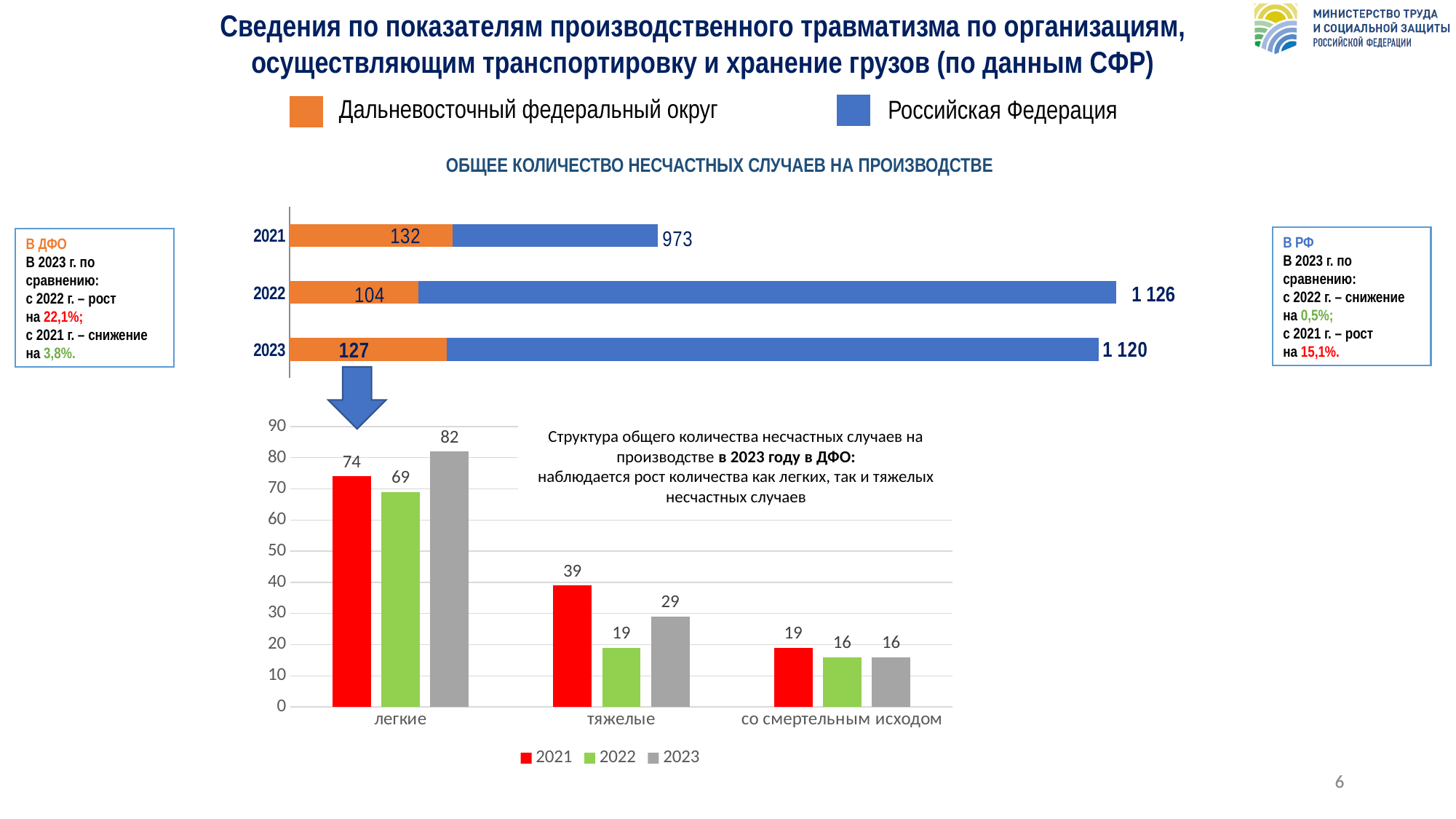
In the bottom chart, what is the value for легкие in 2023? 82 In the top chart 'ОБЩЕЕ КОЛИЧЕСТВО НЕСЧАСТНЫХ СЛУЧАЕВ НА ПРОИЗВОДСТВЕ', what is the difference between the Российская Федерация values for 2022 and 2021? 153 In the top chart 'ОБЩЕЕ КОЛИЧЕСТВО НЕСЧАСТНЫХ СЛУЧАЕВ НА ПРОИЗВОДСТВЕ', what is the value for Дальневосточный федеральный округ in 2021? 132 In the bottom chart, how many series does the legend list? 3 In the top chart 'ОБЩЕЕ КОЛИЧЕСТВО НЕСЧАСТНЫХ СЛУЧАЕВ НА ПРОИЗВОДСТВЕ', what is the value for Российская Федерация in 2022? 1 126 What kind of chart is the bottom chart? Bar chart In the bottom chart, what is the value for тяжелые in 2022? 19 In the top chart 'ОБЩЕЕ КОЛИЧЕСТВО НЕСЧАСТНЫХ СЛУЧАЕВ НА ПРОИЗВОДСТВЕ', in which year is the value for Дальневосточный федеральный округ lowest? 2022 In the bottom chart, which category has the highest value in 2021? легкие In the bottom chart, which is larger: the 2021 value for тяжелые or the 2023 value for тяжелые? 2021 value for тяжелые In the top chart 'ОБЩЕЕ КОЛИЧЕСТВО НЕСЧАСТНЫХ СЛУЧАЕВ НА ПРОИЗВОДСТВЕ', what is the value for Дальневосточный федеральный округ in 2023? 127 In the top chart 'ОБЩЕЕ КОЛИЧЕСТВО НЕСЧАСТНЫХ СЛУЧАЕВ НА ПРОИЗВОДСТВЕ', how many years are shown? 3